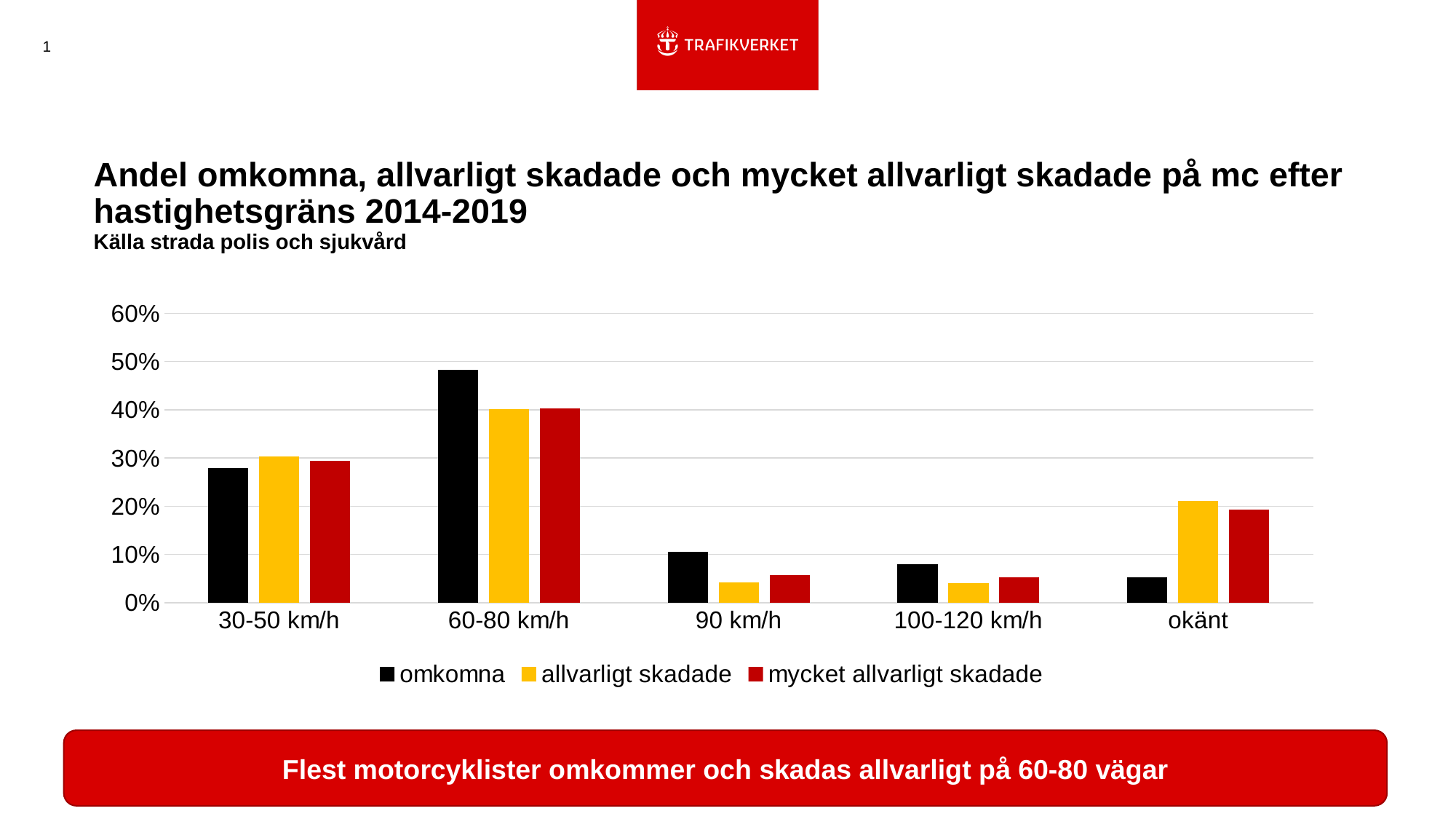
What colour represents the omkomna series in the legend? black In the okänt category, which is larger: omkomna or allvarligt skadade? allvarligt skadade What kind of chart is shown on the slide? bar chart Is the value for omkomna at 60-80 km/h greater or less than 40%? greater At 90 km/h, which is larger: omkomna or allvarligt skadade? omkomna How many series does the legend list? 3 Is the value for mycket allvarligt skadade at 100-120 km/h greater or less than 10%? less Which speed-limit category has the highest value for allvarligt skadade? 60-80 km/h Which speed-limit category has the highest value for omkomna? 60-80 km/h How many speed-limit categories are shown on the x axis? 5 Is the value for allvarligt skadade at 30-50 km/h greater or less than 20%? greater Which speed-limit category has the lowest value for omkomna? okänt